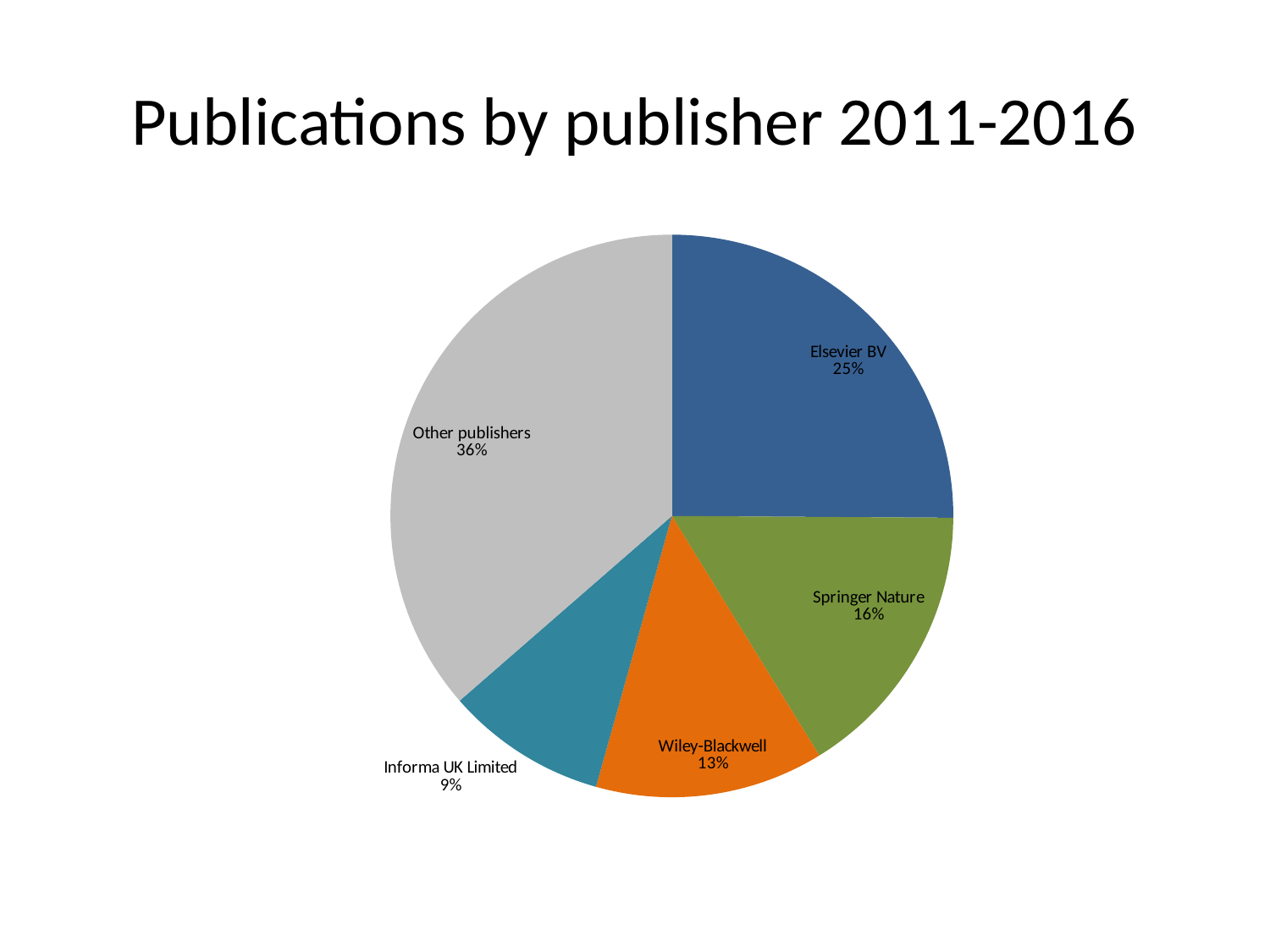
Which has a larger share, Wiley-Blackwell or Springer Nature? Springer Nature What is the title of the chart? Publications by publisher 2011-2016 What kind of chart is shown on the slide? pie chart What colour is the Other publishers slice? grey Which slice of the pie is the largest? Other publishers What share of publications does Wiley-Blackwell account for? 13% What share of publications does Informa UK Limited account for? 9% How many slices does the pie chart have? 5 What share of publications does Elsevier BV account for? 25% What share of publications does Springer Nature account for? 16% Which named publisher has the smallest share? Informa UK Limited What is the difference in percentage points between Elsevier BV and Springer Nature? 9